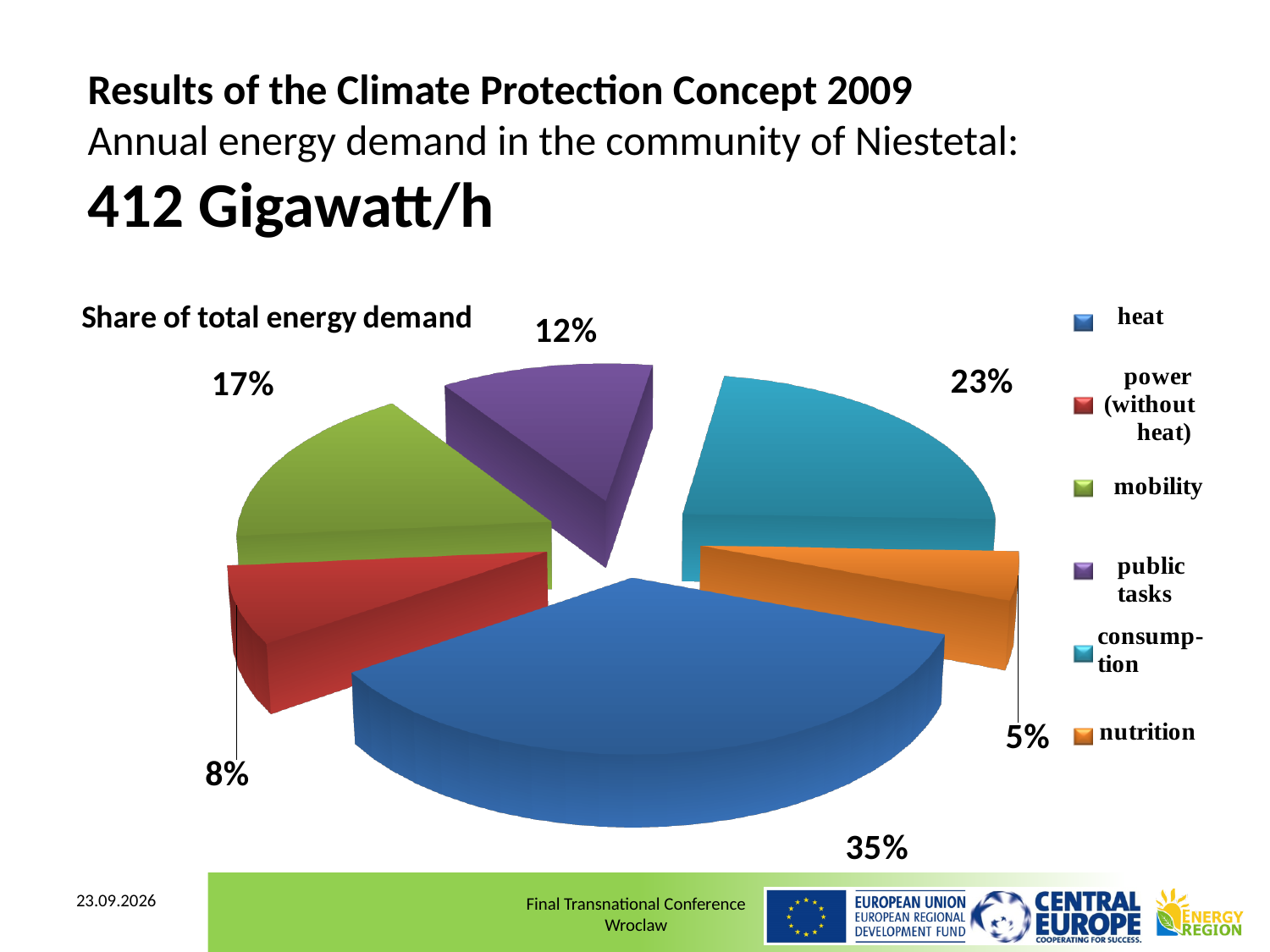
What is the share of total energy demand for mobility? 17% Which category has the largest share of total energy demand? heat How many percentage points larger is the share for consumption than the share for power (without heat)? 15 What is the share of total energy demand for nutrition? 5% Which category has the smallest share of total energy demand? nutrition What type of chart is shown on the slide? pie chart What is the title of the pie chart? Share of total energy demand How many categories does the legend of the pie chart list? 6 What is the share of total energy demand for public tasks? 12% What is the share of total energy demand for consumption? 23% What is the share of total energy demand for heat? 35% Which has a larger share of total energy demand, mobility or public tasks? mobility